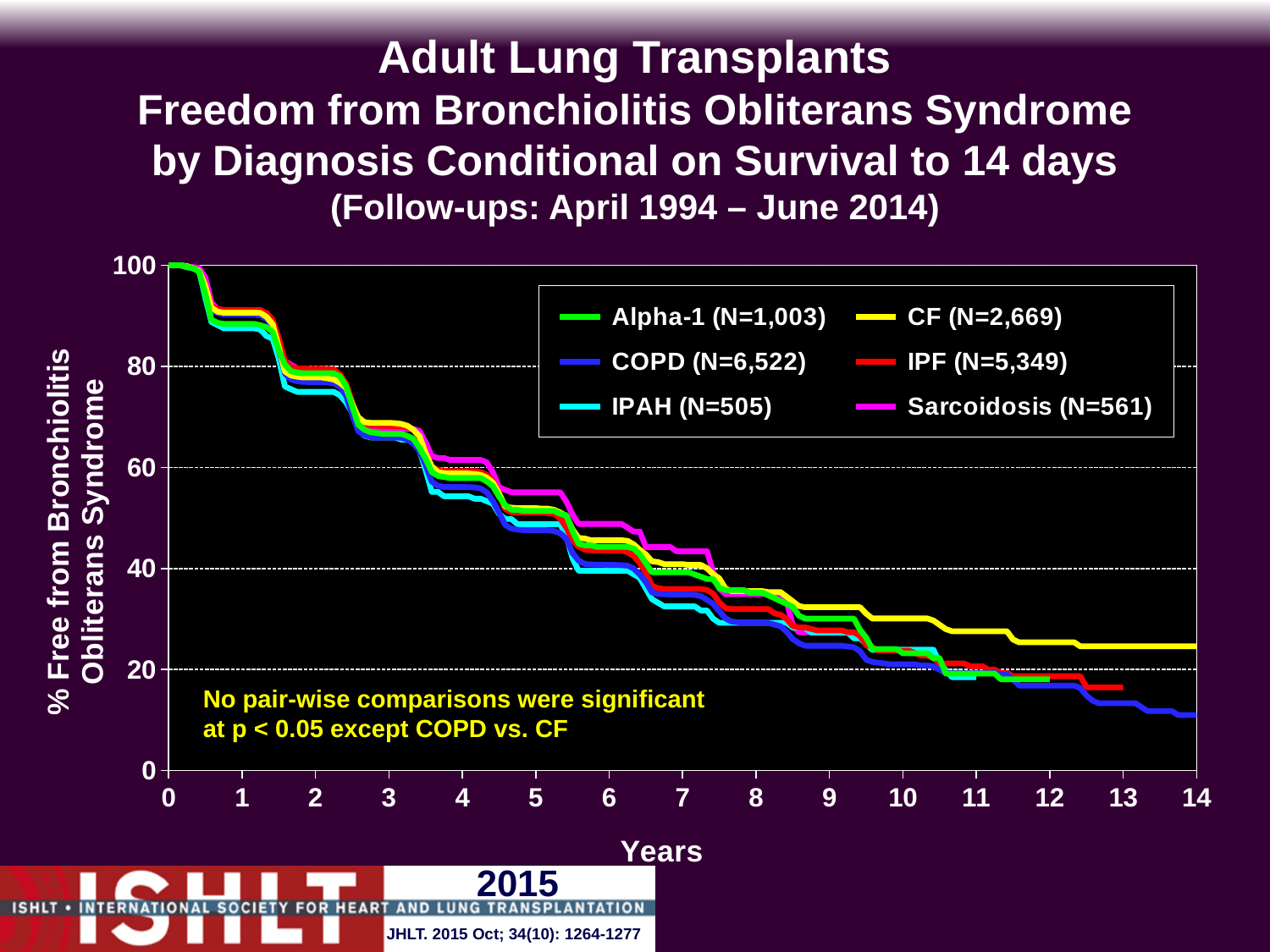
Is the value for CF at year 14 greater or less than 20? greater Which diagnosis group has the highest freedom from bronchiolitis obliterans syndrome at year 14? CF At year 14, which is larger, the value for CF or the value for COPD? CF Is the value for IPAH at year 10 greater or less than 40? less How many series does the legend list? 6 What kind of chart is shown on the slide? line chart Is the value for Alpha-1 at year 1 greater or less than 80? greater Which diagnosis group has the lowest freedom from bronchiolitis obliterans syndrome at year 14? COPD What is the label of the y axis? % Free from Bronchiolitis Obliterans Syndrome Do the curves rise or fall as the years increase along the x axis? fall What is the sample size (N) shown in the legend for COPD? 6,522